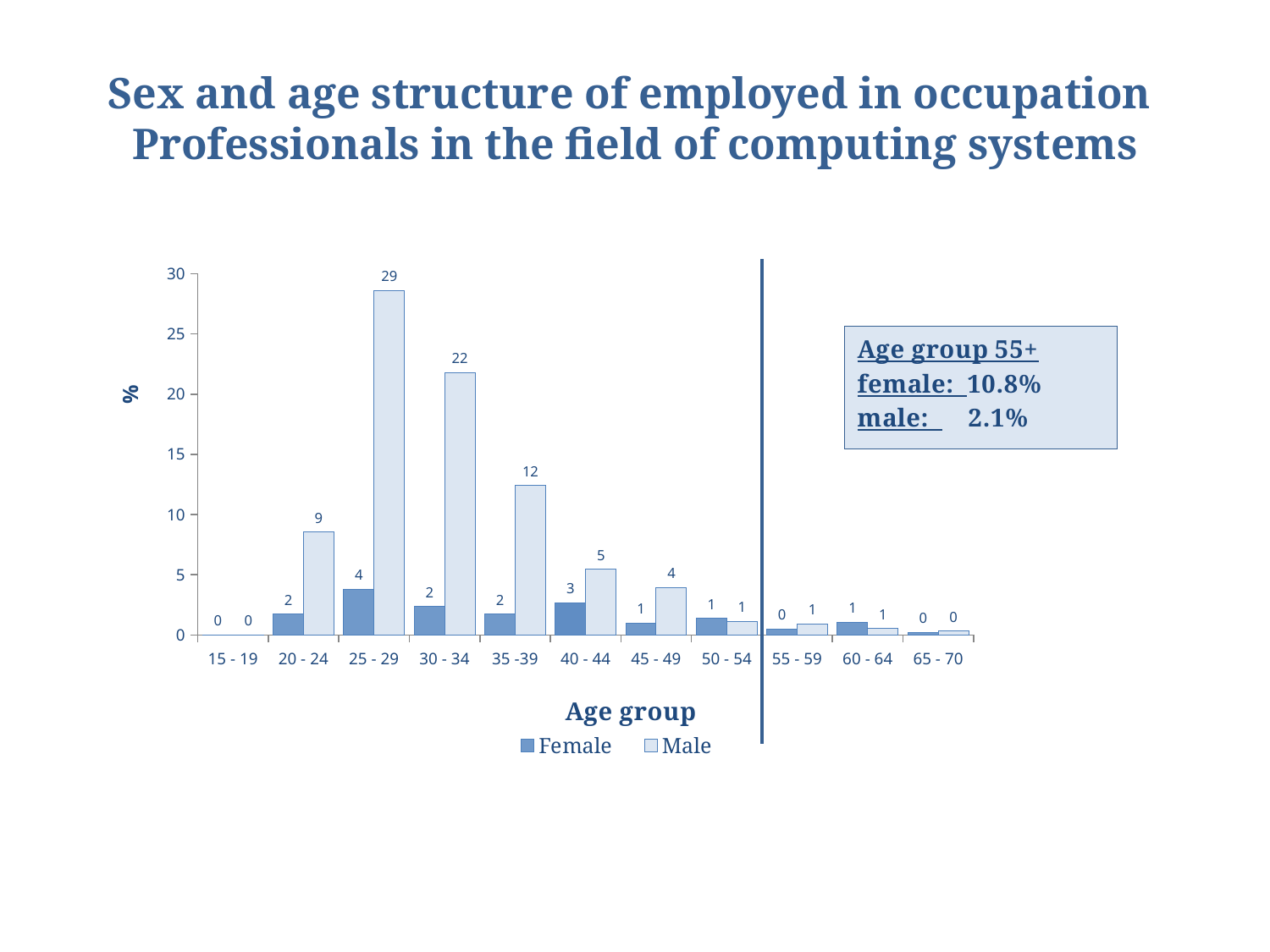
Do the Male values rise or fall from the 25 - 29 age group to the 50 - 54 age group? fall Which age group has the highest Female value? 25 - 29 What is the difference between the Male and Female values for the 30 - 34 age group? 20 What is the Male value for the 35 -39 age group? 12 How many age groups are shown on the x axis? 11 What is the Male value for the 25 - 29 age group? 29 What is the label on the y axis? % Which is larger for the 20 - 24 age group, the Female value or the Male value? Male Which age group has the highest Male value? 25 - 29 What is the Female value for the 40 - 44 age group? 3 What type of chart is shown on the slide? bar chart How many series does the legend list? 2